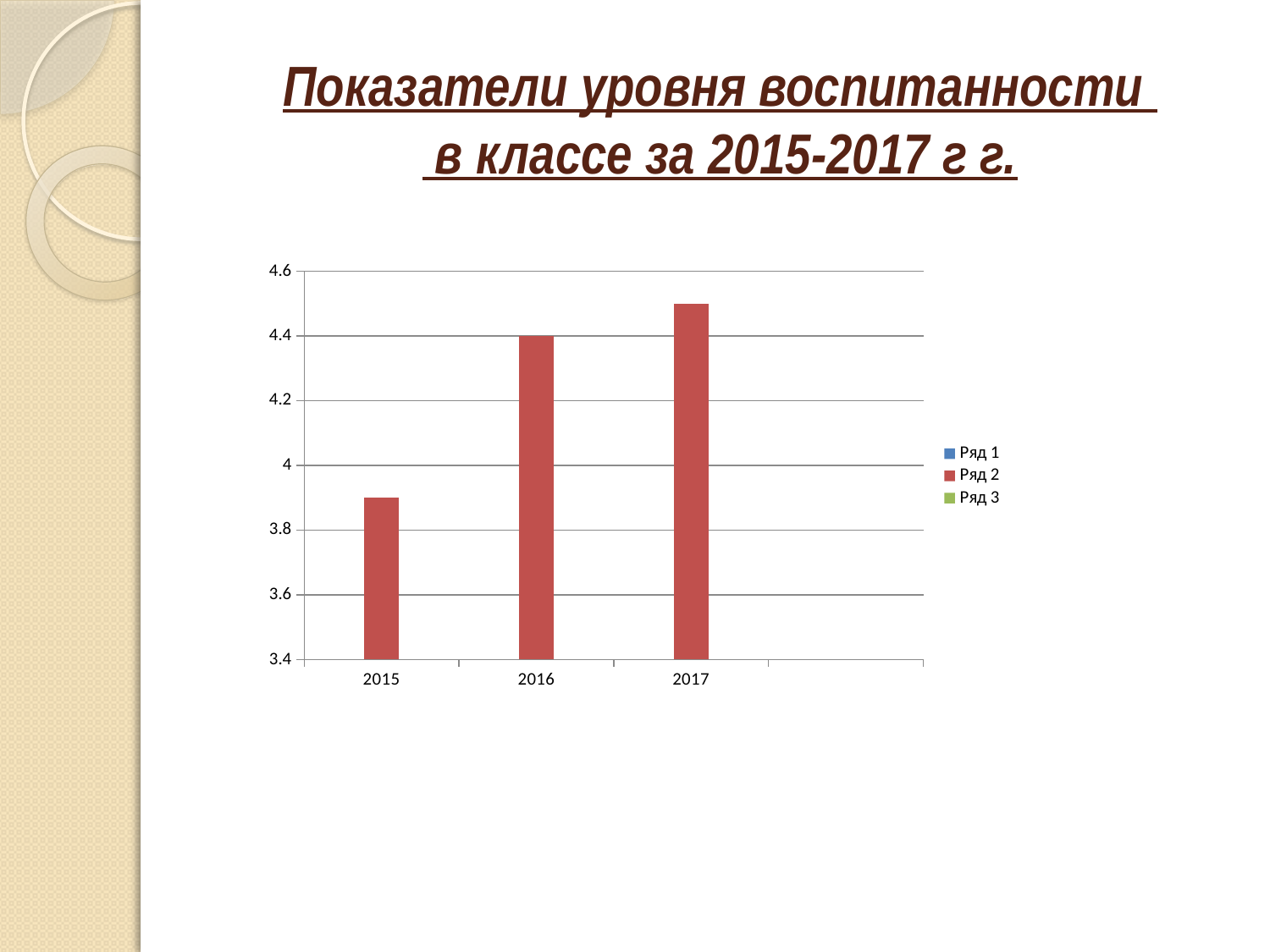
Which year has the highest bar? 2017 Is the value for 2017 greater or less than 4.4? greater What kind of chart is shown on the slide? bar chart Do the values rise or fall from 2015 to 2017? rise Which is larger, the value for 2015 or the value for 2016? 2016 Is the value for 2015 greater or less than 3.8? greater What is the value for 2016? 4.4 Which legend entry corresponds to the red bars plotted on the chart? Ряд 2 Is the value for 2015 greater or less than 4? less How many series does the legend list? 3 Which year has the lowest bar? 2015 How many years are shown on the x axis of the chart? 3